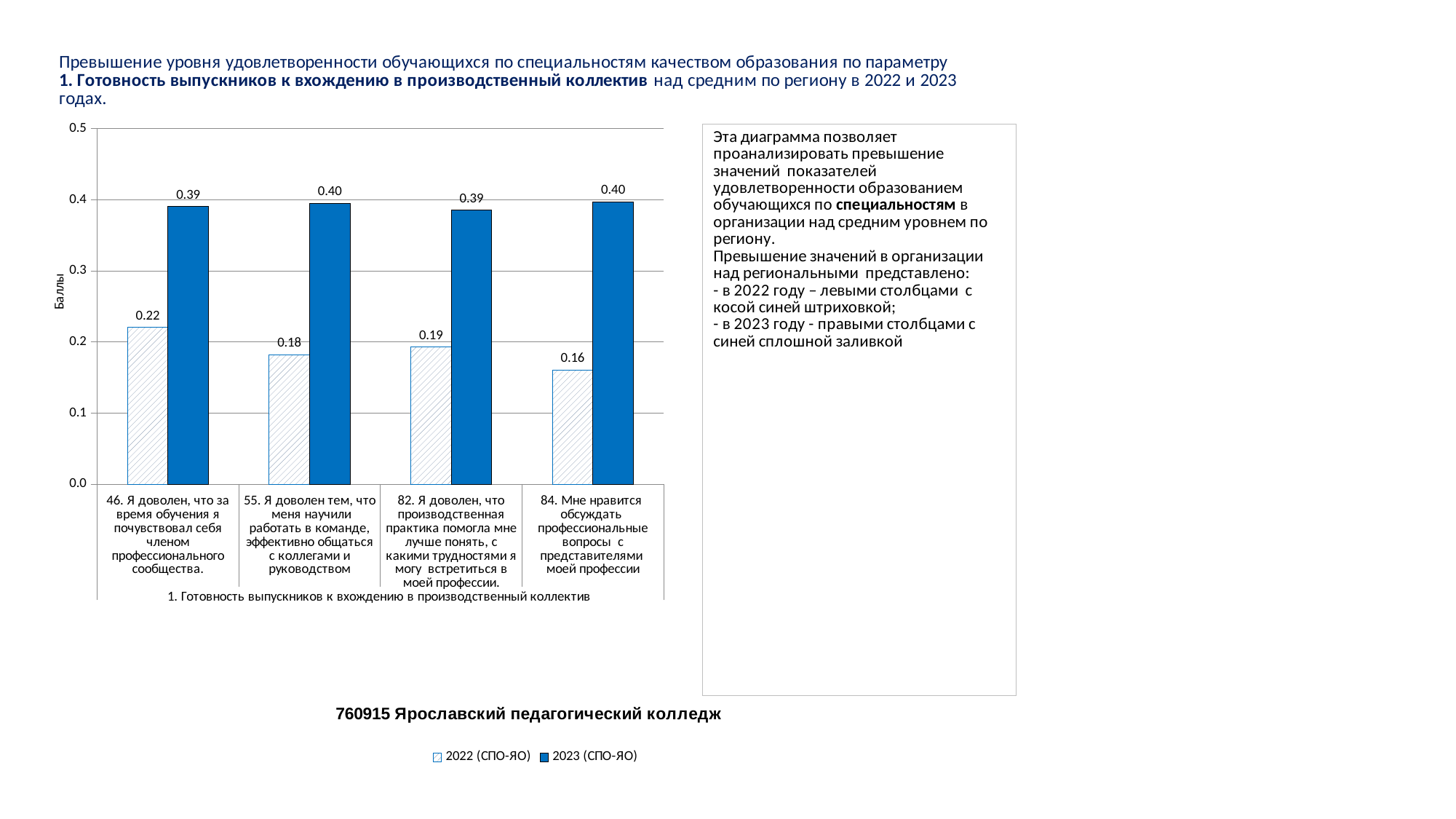
Which category has the highest value for the 2022 (СПО-ЯО) series? 46. Я доволен, что за время обучения я почувствовал себя членом профессионального сообщества. How many categories are shown on the x axis of the chart? 4 How many series does the chart legend list? 2 What is the value for 2023 (СПО-ЯО) for category "84. Мне нравится обсуждать профессиональные вопросы с представителями моей профессии"? 0.40 What kind of chart is shown on the slide? Bar chart What is the difference between the 2023 (СПО-ЯО) and 2022 (СПО-ЯО) values for category "46. Я доволен, что за время обучения я почувствовал себя членом профессионального сообщества."? 0.17 What is the value for 2022 (СПО-ЯО) for category "55. Я доволен тем, что меня научили работать в команде, эффективно общаться с коллегами и руководством"? 0.18 What is the difference between the 2023 (СПО-ЯО) and 2022 (СПО-ЯО) values for category "84. Мне нравится обсуждать профессиональные вопросы с представителями моей профессии"? 0.24 For the 2022 (СПО-ЯО) series, which is larger: the value for category 46 or the value for category 55? Category 46 Is the 2022 (СПО-ЯО) value for category "84. Мне нравится обсуждать профессиональные вопросы с представителями моей профессии" greater or less than 0.2? less What is the value for 2023 (СПО-ЯО) for category "46. Я доволен, что за время обучения я почувствовал себя членом профессионального сообщества."? 0.39 Which category has the lowest value for the 2022 (СПО-ЯО) series? 84. Мне нравится обсуждать профессиональные вопросы с представителями моей профессии